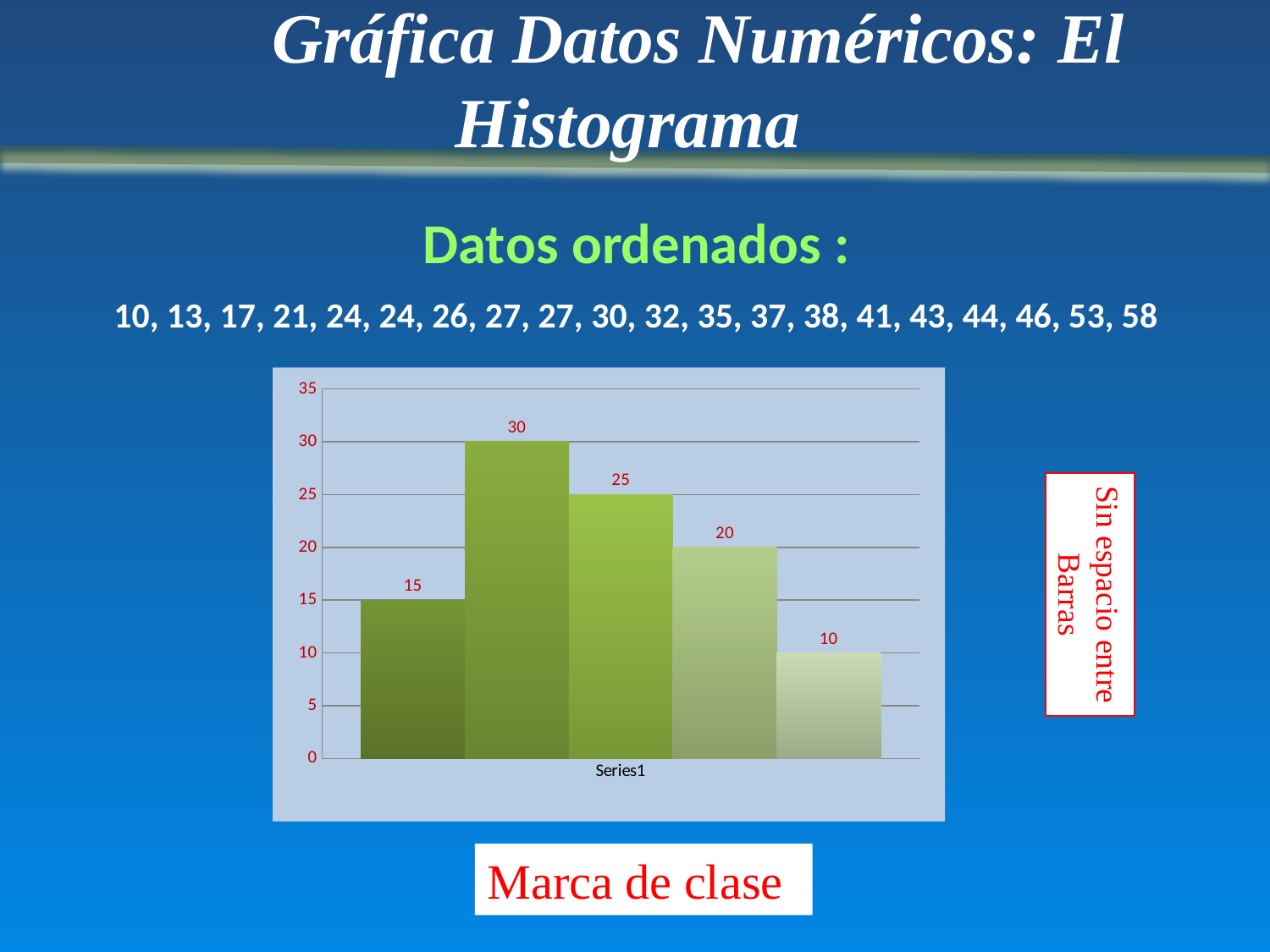
What kind of chart is shown on the slide? bar chart What is the value of the last (rightmost) bar in the chart? 10 What is the maximum value shown on the vertical axis of the chart? 35 What is the difference between the third bar (25) and the fourth bar (20)? 5 Which bar has the lowest value in the chart? the fifth bar (10) How many bars are plotted in the chart? 5 What is the value of the second bar from the left in the chart? 30 What label appears on the horizontal axis of the chart? Series1 What is the difference between the highest bar and the lowest bar in the chart? 20 Which is larger, the first bar or the fourth bar? the fourth bar Which bar has the highest value in the chart? the second bar (30) What is the value of the first (leftmost) bar in the chart? 15